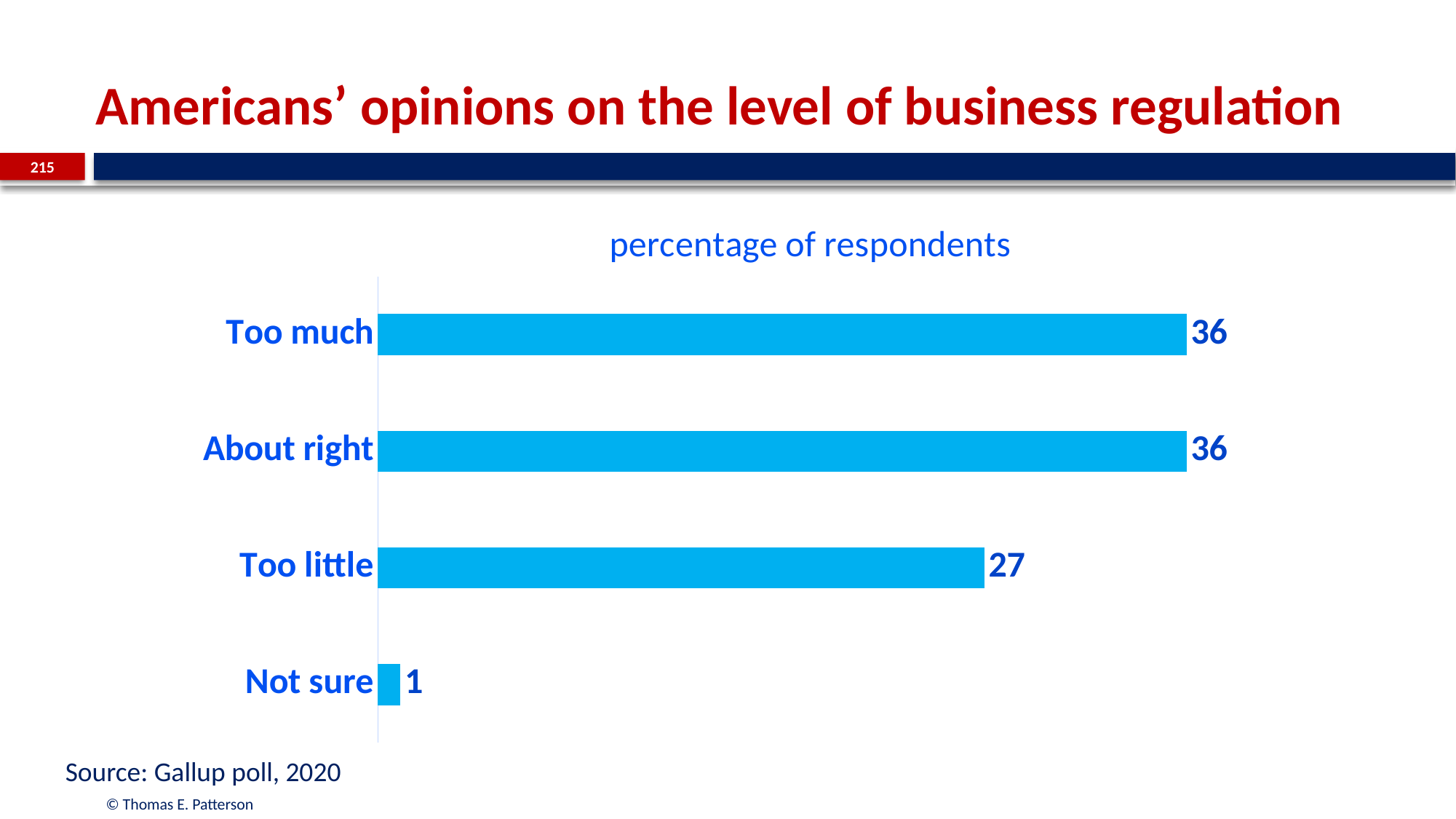
What is the value for the 'About right' category? 36 What is the value for the 'Too little' category? 27 What kind of chart is shown on the slide? Bar chart What is the title of the chart? percentage of respondents What percentage of respondents said there is too much business regulation? 36 Which category has the lowest value? Not sure What is the source cited for the chart data? Gallup poll, 2020 How many categories are shown in the chart? 4 What is the difference between the values for 'Too little' and 'Not sure'? 26 What is the difference between the values for 'Too much' and 'Too little'? 9 What is the value for the 'Not sure' category? 1 Which is larger, the value for 'About right' or the value for 'Too little'? About right